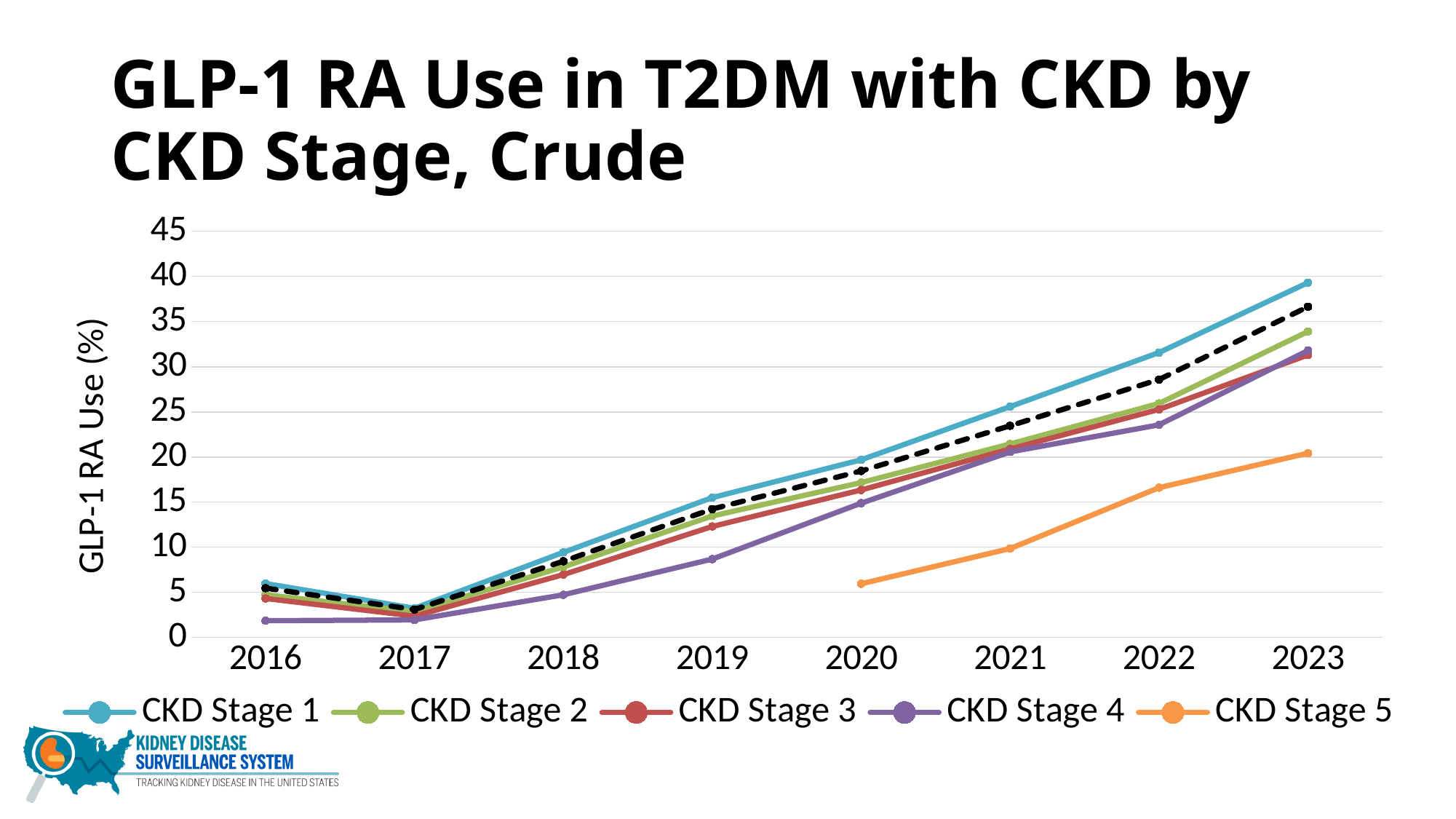
How many years are shown on the x axis? 8 Which CKD stage has the highest GLP-1 RA use in 2023? CKD Stage 1 Is the value for CKD Stage 1 in 2023 greater or less than 35? greater In 2022, which is larger: the value for CKD Stage 1 or CKD Stage 5? CKD Stage 1 Is the value for CKD Stage 5 in 2023 greater or less than 25? less What kind of chart is shown on the slide? line chart How many series does the legend list? 5 Which series in the legend only has data starting in 2020? CKD Stage 5 Which CKD stage has the lowest GLP-1 RA use in 2023? CKD Stage 5 Is the value for CKD Stage 5 in 2020 greater or less than 10? less Does GLP-1 RA use for CKD Stage 1 rise or fall from 2017 to 2023? rise